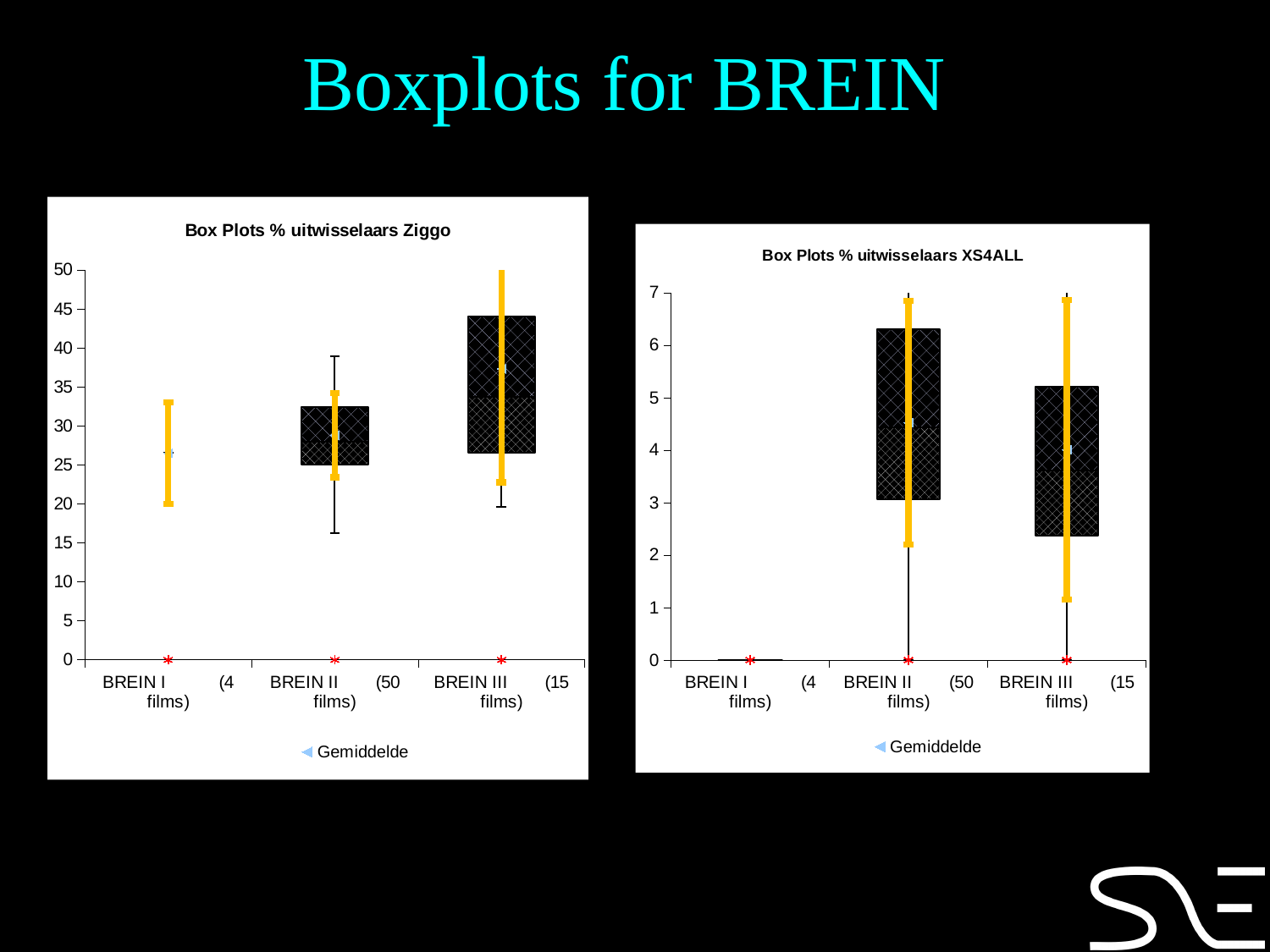
In the left chart 'Box Plots % uitwisselaars Ziggo', which category's box reaches higher, BREIN II or BREIN III? BREIN III How many entries does the legend of the left chart 'Box Plots % uitwisselaars Ziggo' list? 1 In the right chart 'Box Plots % uitwisselaars XS4ALL', which category has the lowest values? BREIN I In the left chart 'Box Plots % uitwisselaars Ziggo', is the bottom of the BREIN II box greater or less than 30? less In the right chart 'Box Plots % uitwisselaars XS4ALL', is the top of the BREIN III box greater or less than 6? less What is the title of the left chart on the slide? Box Plots % uitwisselaars Ziggo In the right chart 'Box Plots % uitwisselaars XS4ALL', is the top of the BREIN II box greater or less than 6? greater What is the legend entry shown below the right chart 'Box Plots % uitwisselaars XS4ALL'? Gemiddelde What kind of chart is the left chart titled 'Box Plots % uitwisselaars Ziggo'? box plot In the right chart 'Box Plots % uitwisselaars XS4ALL', which category's box reaches higher, BREIN II or BREIN III? BREIN II How many categories are shown on the x axis of the right chart 'Box Plots % uitwisselaars XS4ALL'? 3